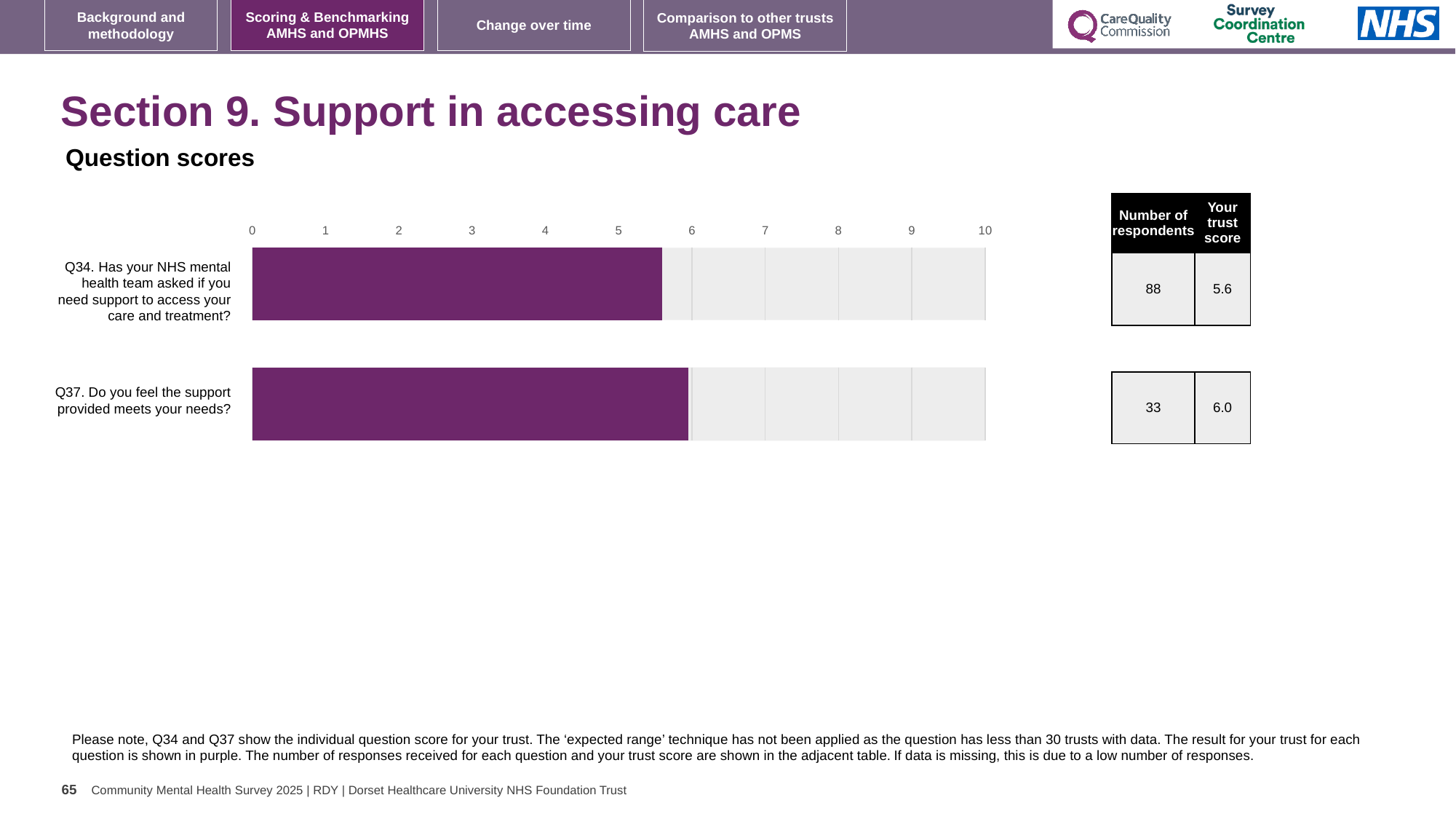
How many respondents answered Q34? 88 Which question has the lowest trust score? Q34 How many respondents answered Q37? 33 What is the trust score for Q37 (Do you feel the support provided meets your needs?)? 6.0 What is the maximum value shown on the chart's axis? 10 Is the trust score for Q37 greater or less than 5? greater What is the difference between the trust scores for Q37 and Q34? 0.4 What kind of chart is shown on the slide? Bar chart What is the trust score for Q34 (Has your NHS mental health team asked if you need support to access your care and treatment?)? 5.6 How many questions are plotted in the chart? 2 Is the trust score for Q34 greater or less than 6? less Which question has the higher trust score, Q34 or Q37? Q37